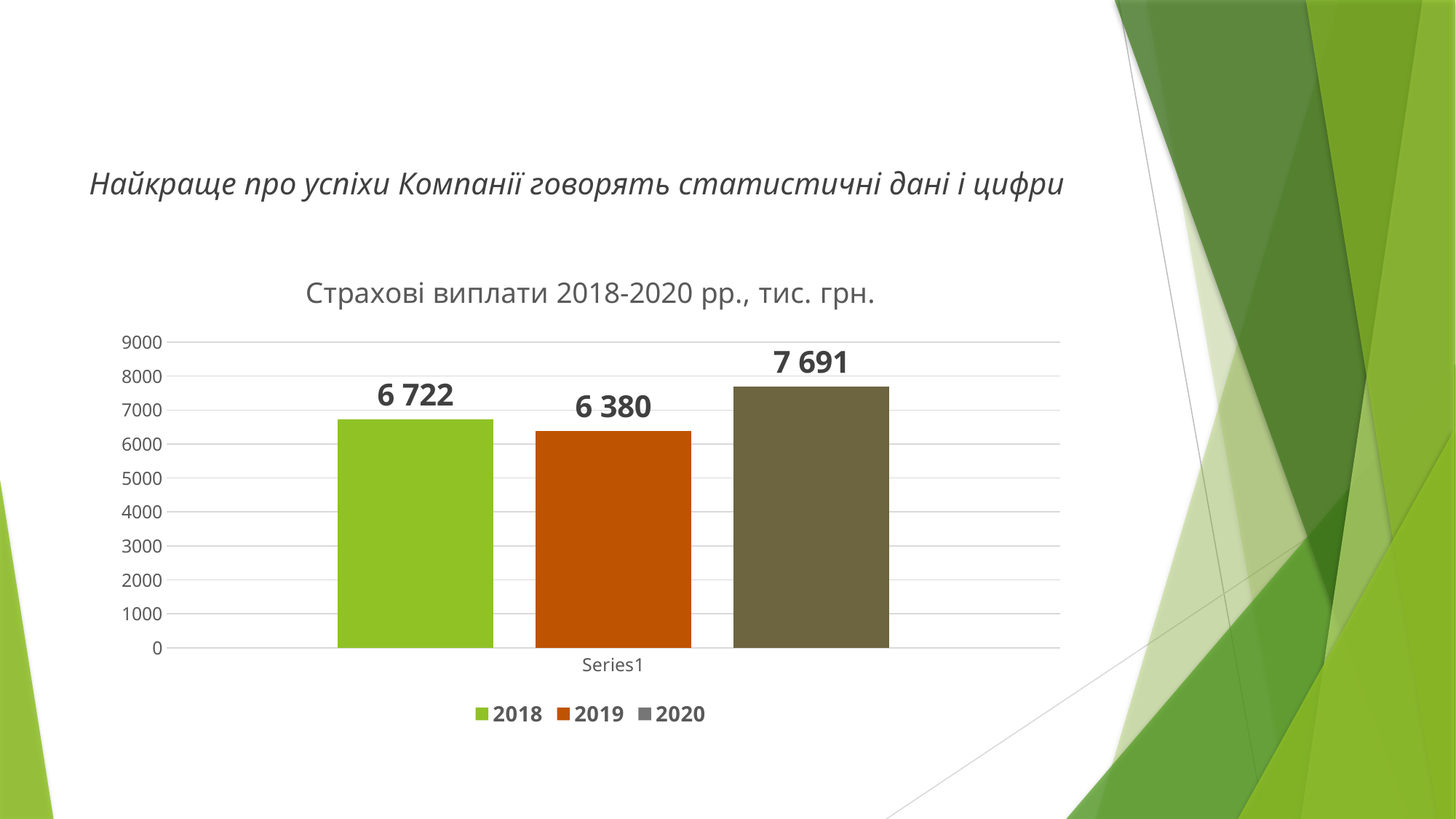
What is the difference between the values for 2018 and 2019? 342 What is the difference between the values for 2020 and 2019? 1 311 What kind of chart is shown on the slide? bar chart Is the value for 2020 greater or less than 7000? greater Which year has the highest value? 2020 What is the value for 2020? 7 691 What is the title of the chart? Страхові виплати 2018-2020 рр., тис. грн. What is the value for 2019? 6 380 What is the value for 2018? 6 722 Which is larger, the value for 2018 or the value for 2020? 2020 Which year has the lowest value? 2019 How many series does the legend list? 3